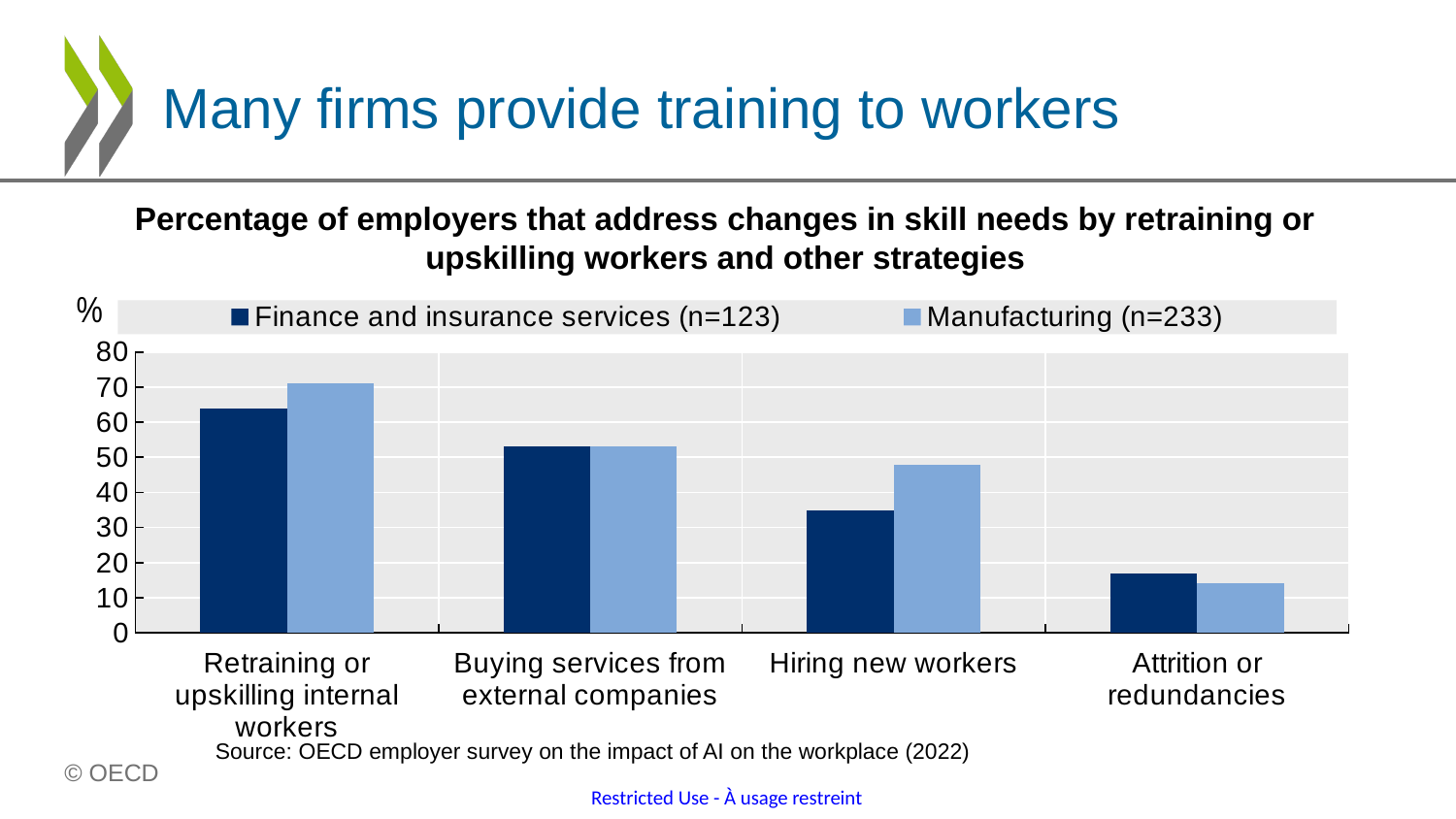
What kind of chart is shown on the slide? bar chart Which category has the lowest value for Finance and insurance services (n=123)? Attrition or redundancies What is the sample size (n) given in the legend for Manufacturing? 233 Is the value for Finance and insurance services for Hiring new workers greater or less than 40? less How many categories are shown on the x axis? 4 Which category has the highest value for Manufacturing (n=233)? Retraining or upskilling internal workers Is the value for Finance and insurance services for Retraining or upskilling internal workers greater or less than 60? greater How many series does the legend list? 2 Is the value for Manufacturing for Hiring new workers greater or less than 40? greater For Retraining or upskilling internal workers, which series has the larger value: Finance and insurance services or Manufacturing? Manufacturing (n=233) For Hiring new workers, which series has the larger value: Finance and insurance services or Manufacturing? Manufacturing (n=233)